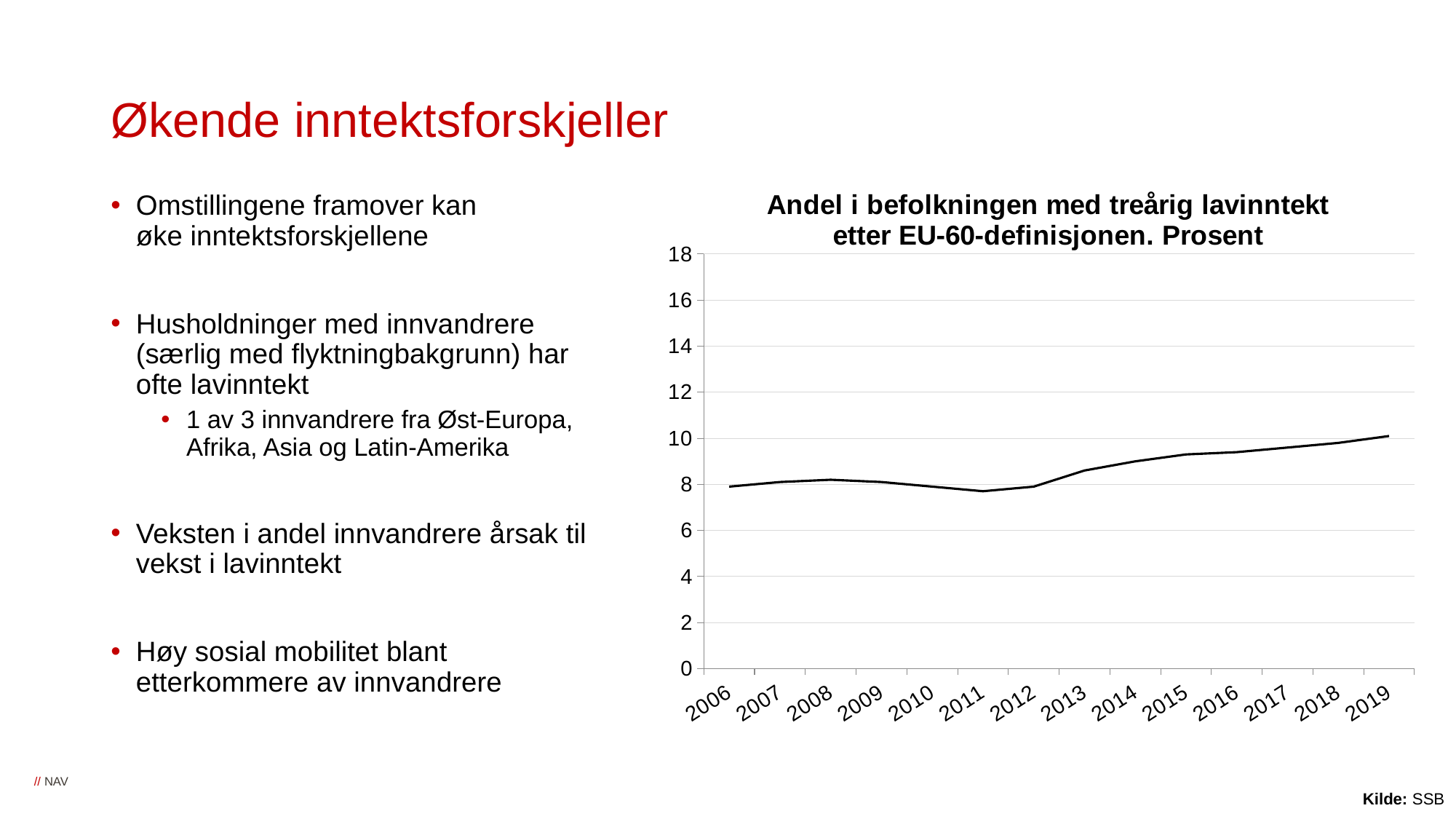
Is the value for 2019 greater or less than 8? greater Is the value for 2006 greater or less than 10? less What is the title of the chart? Andel i befolkningen med treårig lavinntekt etter EU-60-definisjonen. Prosent How many years are shown on the x axis of the chart? 14 Which is larger, the value for 2019 or the value for 2006? 2019 Is the value for 2011 greater or less than 8? less Does the value rise or fall from 2012 to 2019? rise Which year has the lowest value in the chart? 2011 Which is larger, the value for 2011 or the value for 2015? 2015 Which year has the highest value in the chart? 2019 What kind of chart is shown on the slide? line chart